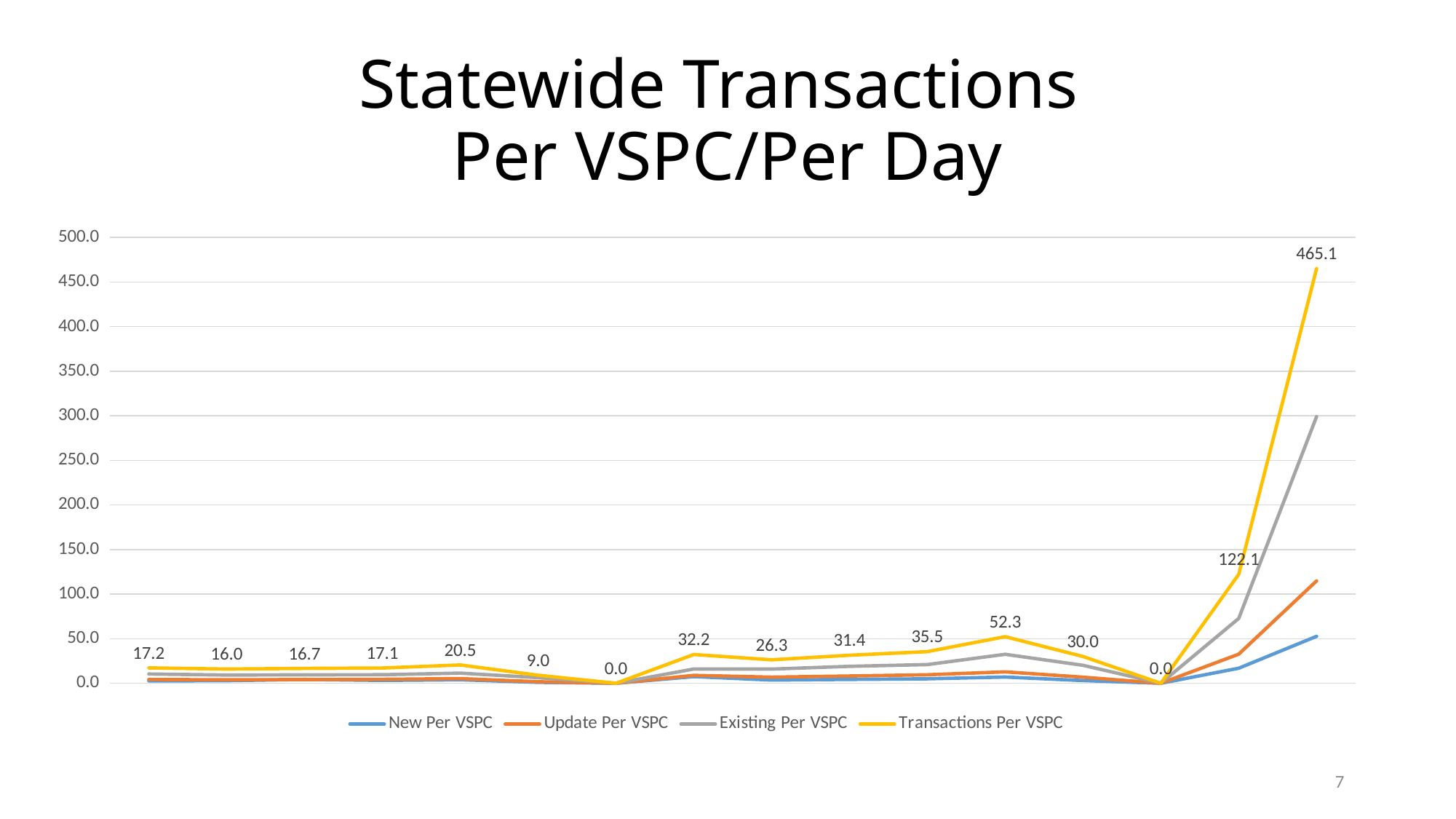
Which series reaches the highest value at the final point on the x axis? Transactions Per VSPC How many data points are plotted for the Transactions Per VSPC series? 16 What is the labelled value of the first point of the Transactions Per VSPC series? 17.2 Is the final value of the New Per VSPC series greater or less than 100.0? less What is the labelled value of the second-to-last point of the Transactions Per VSPC series? 122.1 What is the lowest labelled value for the Transactions Per VSPC series? 0.0 What kind of chart is shown on the slide? line chart What colour is the Transactions Per VSPC line in the legend? yellow Is the final value of the Existing Per VSPC series greater or less than 250.0? greater How many series does the legend list? 4 What is the highest labelled value for the Transactions Per VSPC series? 465.1 What is the difference between the last two labelled values of the Transactions Per VSPC series (465.1 and 122.1)? 343.0